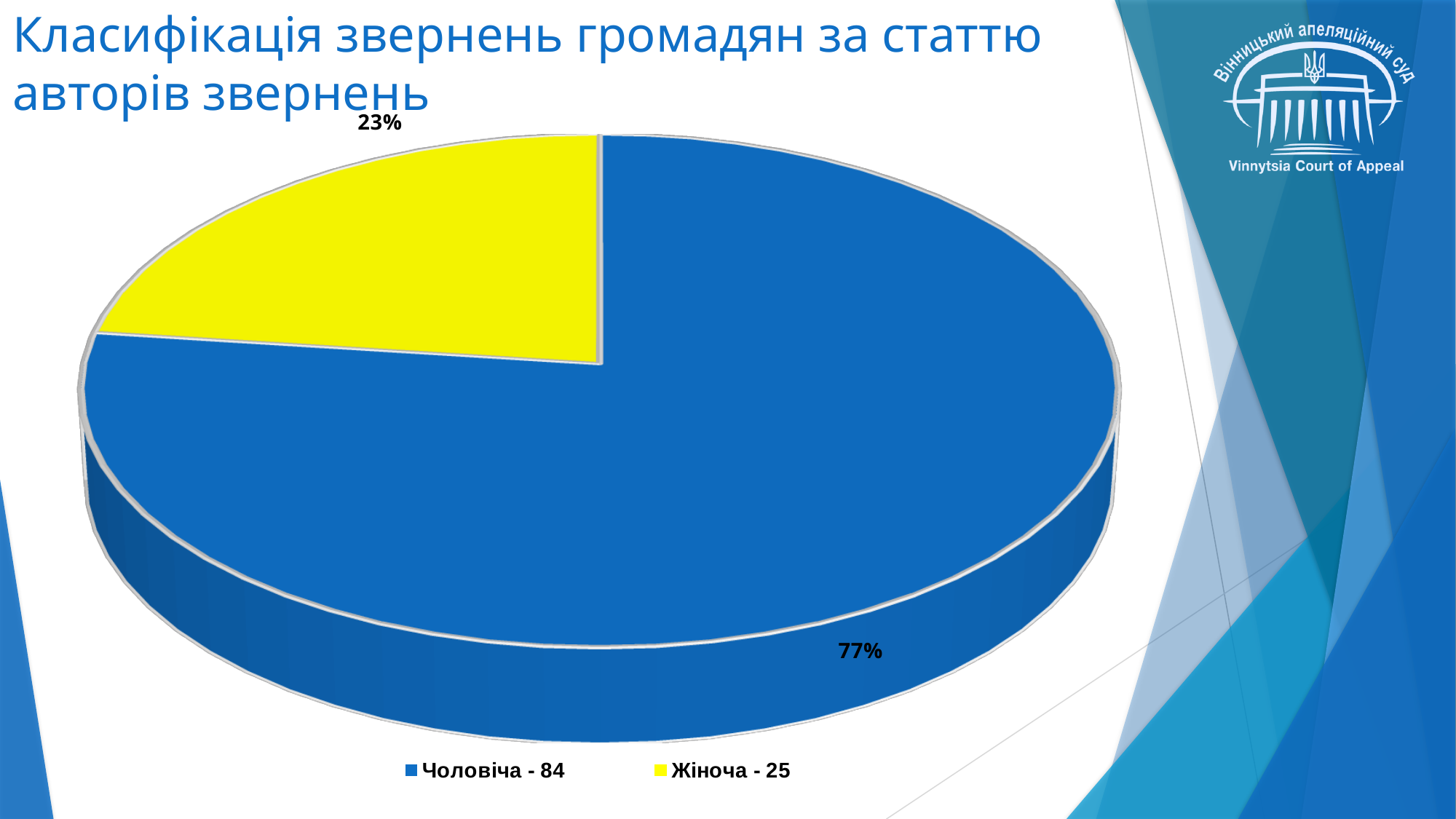
What percentage share is shown for the "Жіноча - 25" slice? 23% What kind of chart is shown on the slide? pie chart What colour is the "Жіноча - 25" slice? yellow Which slice is the smallest in the pie chart? Жіноча - 25 What colour is the "Чоловіча - 84" slice? blue How many slices does the pie chart have? 2 How many entries does the legend list? 2 Which slice is the largest in the pie chart? Чоловіча - 84 Which is larger: the share for "Чоловіча - 84" or the share for "Жіноча - 25"? Чоловіча - 84 What is the difference in percentage points between the "Чоловіча - 84" slice and the "Жіноча - 25" slice? 54 What percentage share is shown for the "Чоловіча - 84" slice? 77%